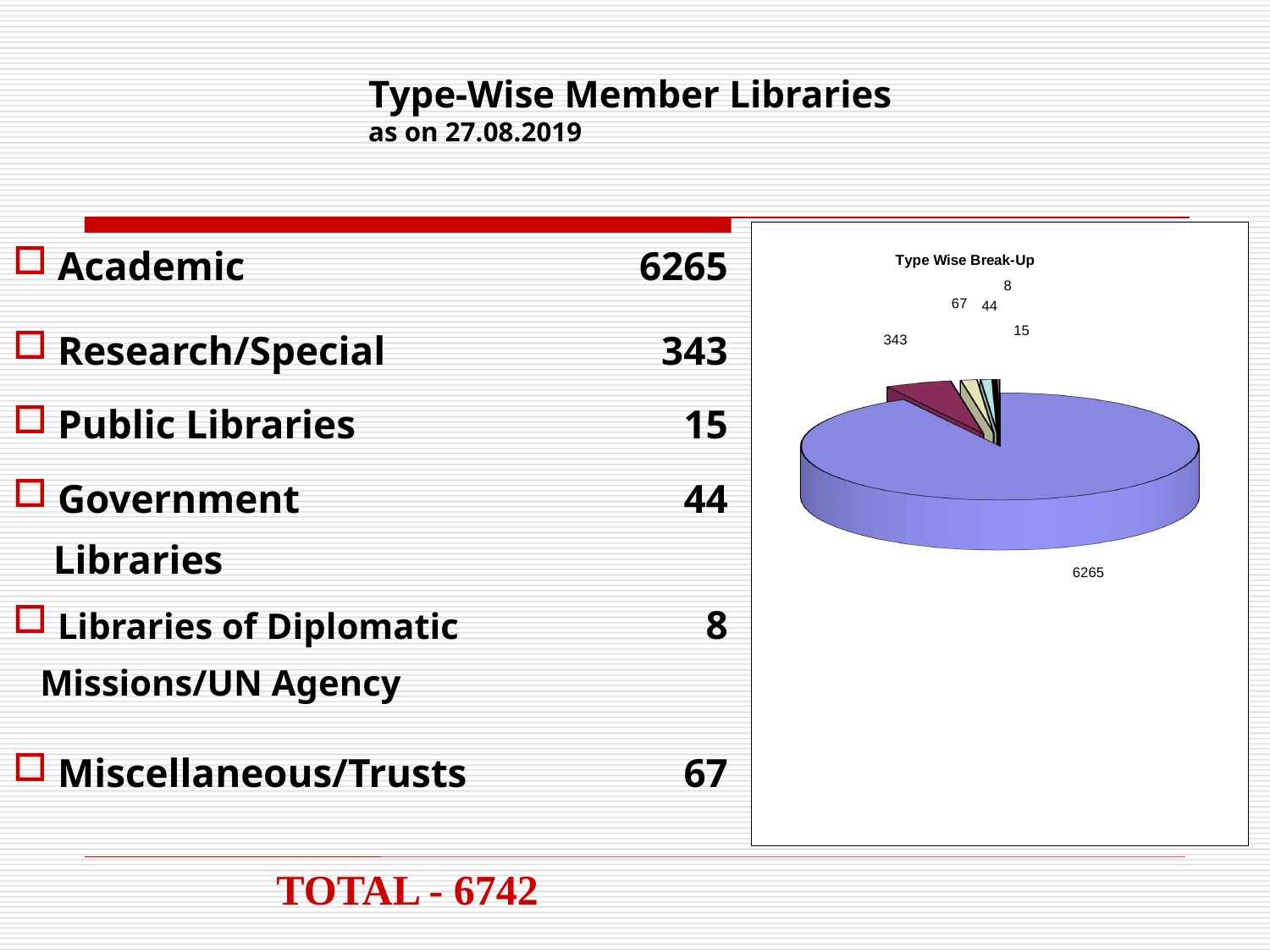
What is the value of the smallest slice in the pie chart? 8 Which category has the smallest slice in the pie chart? Libraries of Diplomatic Missions/UN Agency What kind of chart is shown on the slide? pie chart What is the title of the chart? Type Wise Break-Up Which category has the largest slice in the pie chart? Academic What is the value of the largest slice in the pie chart? 6265 What value is shown for Research/Special in the pie chart? 343 What value is shown for Government Libraries in the pie chart? 44 How many slices does the pie chart have? 6 Which is larger in the pie chart, the slice labelled 67 or the slice labelled 44? 67 What is the difference between the Academic slice (6265) and the Research/Special slice (343)? 5922 What is the total of all the slices in the pie chart? 6742